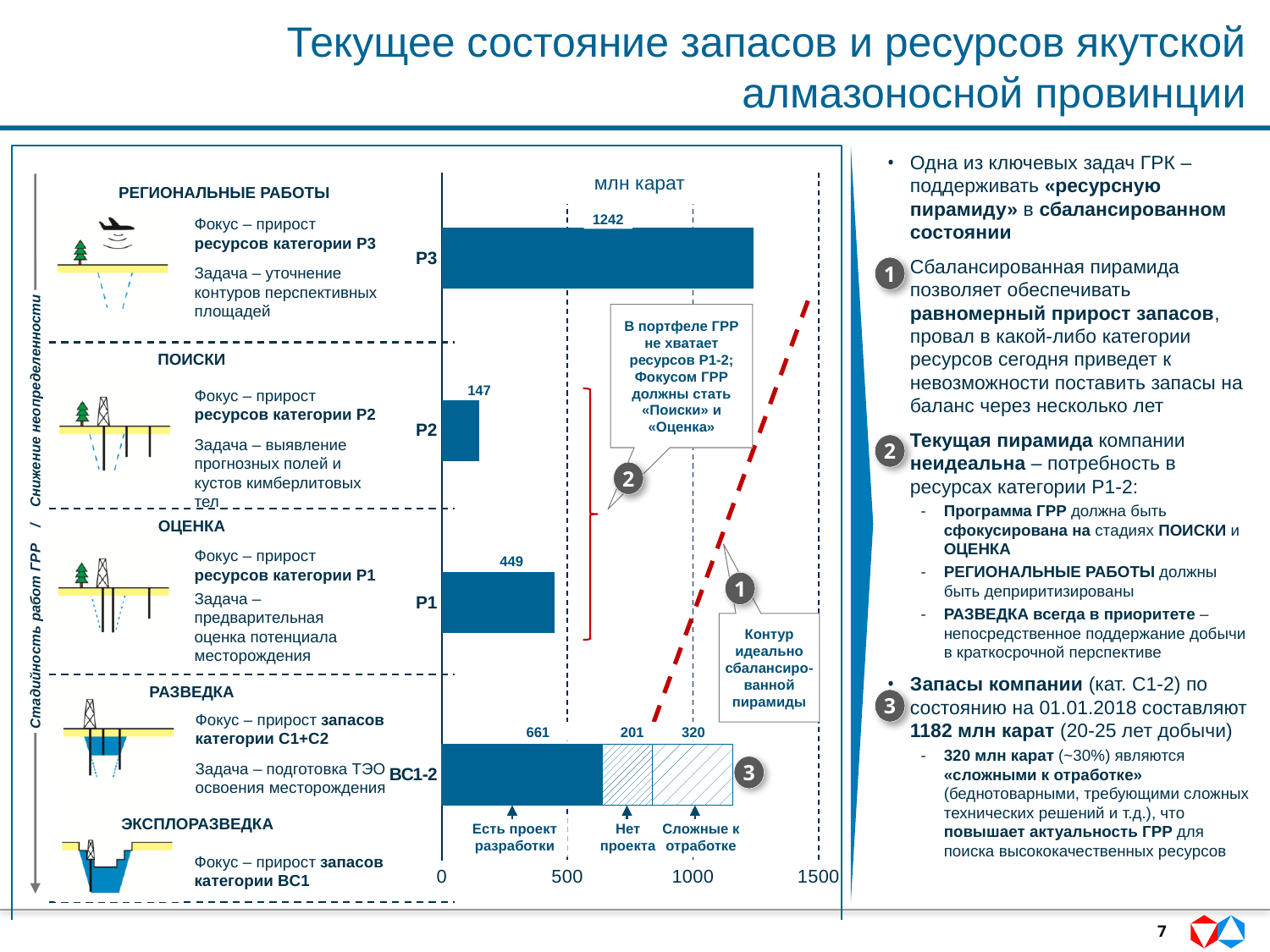
In the bar chart, what is the value of the 'Сложные к отработке' segment of the BC1-2 bar? 320 Which category has the lowest value in the bar chart? P2 Which category has the highest value in the bar chart? P3 In the bar chart, what is the value of the 'Есть проект разработки' segment of the BC1-2 bar? 661 How many categories are shown on the vertical axis of the bar chart? 4 What is the value for category P3 in the bar chart? 1242 What is the total of the stacked BC1-2 bar (661 + 201 + 320)? 1182 What is the difference between the values for P3 and P1 in the bar chart? 793 What unit is shown above the bar chart? млн карат What is the value for category P1 in the bar chart? 449 What is the value for category P2 in the bar chart? 147 Which is larger in the bar chart, the value for P1 or the value for P2? P1